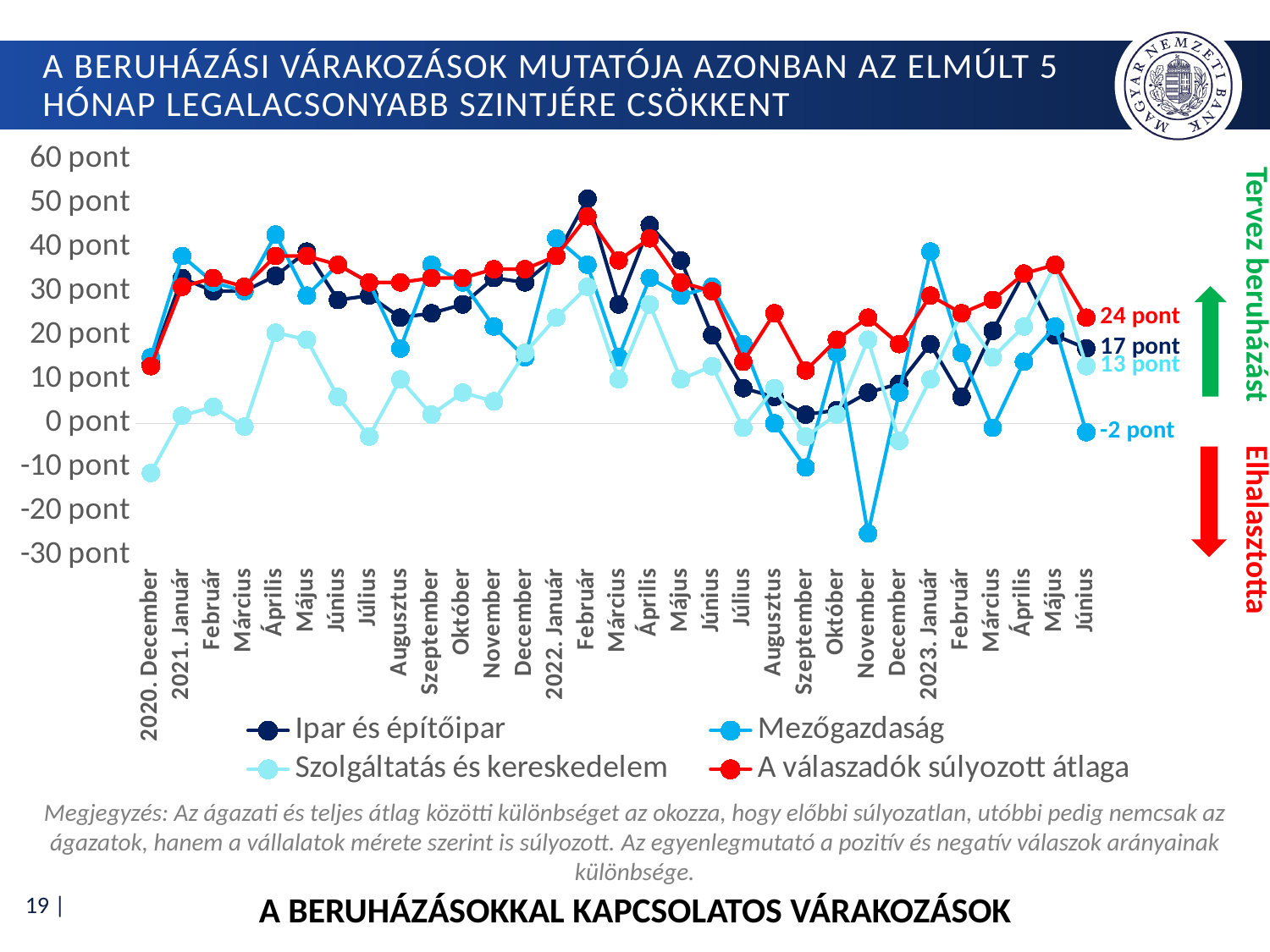
What is the value of 'A válaszadók súlyozott átlaga' for 2023 Június? 24 pont Is the value for 'Mezőgazdaság' in 2022 November greater or less than -20 pont? less How many series does the legend list? 4 What is the value of 'Ipar és építőipar' for 2023 Június? 17 pont What is the value of 'Szolgáltatás és kereskedelem' for 2023 Június? 13 pont What kind of chart is shown on the slide? line chart What is the title shown below the chart? A beruházásokkal kapcsolatos várakozások Which series has the lowest value in 2023 Június? Mezőgazdaság What is the value of 'Mezőgazdaság' for 2023 Június? -2 pont What is the difference between 'A válaszadók súlyozott átlaga' and 'Ipar és építőipar' in 2023 Június? 7 pont In 2023 Június, which is larger: 'Ipar és építőipar' or 'Mezőgazdaság'? Ipar és építőipar Is the value for 'Ipar és építőipar' in 2022 Február greater or less than 40 pont? greater